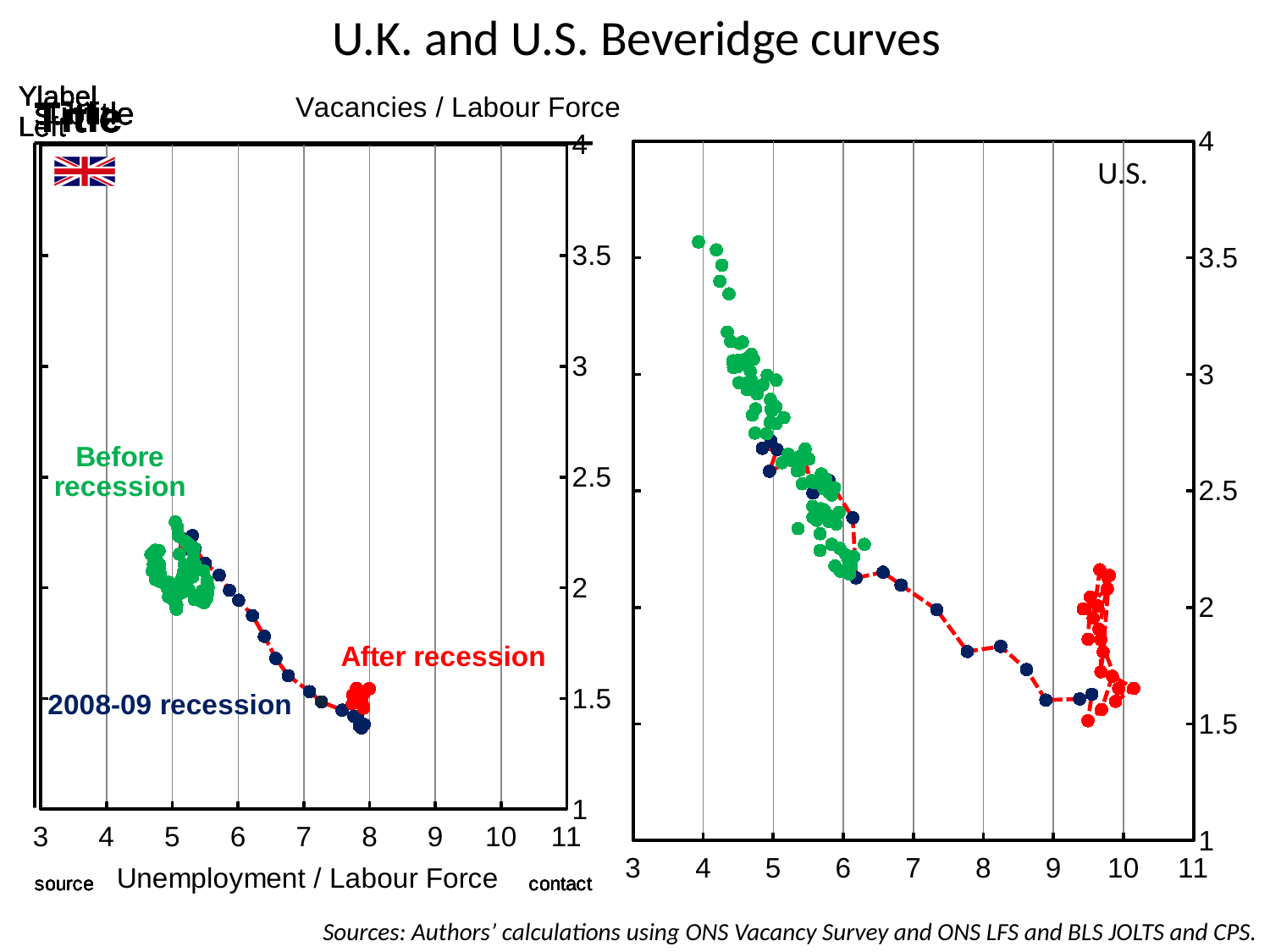
How many charts are shown on the slide? 2 On the U.S. chart, is the highest 'Before recession' vacancy value greater or less than 3? greater Which chart reaches the higher vacancy rate, the U.K. chart or the U.S. chart? U.S. chart On the U.K. chart, are the 'After recession' vacancy values greater or less than 2? less What kind of chart is used for the U.K. Beveridge curve on the left? scatter chart How many labelled phases (series) are shown on the U.K. chart? 3 On the U.K. chart, are the 'Before recession' vacancy values greater or less than 2.5? less On the U.S. chart, do vacancies rise or fall as unemployment increases along the 2008-09 recession path? fall What colour are the 'After recession' points on the U.K. chart? red What is the maximum value shown on the x axis of the U.K. chart? 11 What is the title of the slide? U.K. and U.S. Beveridge curves